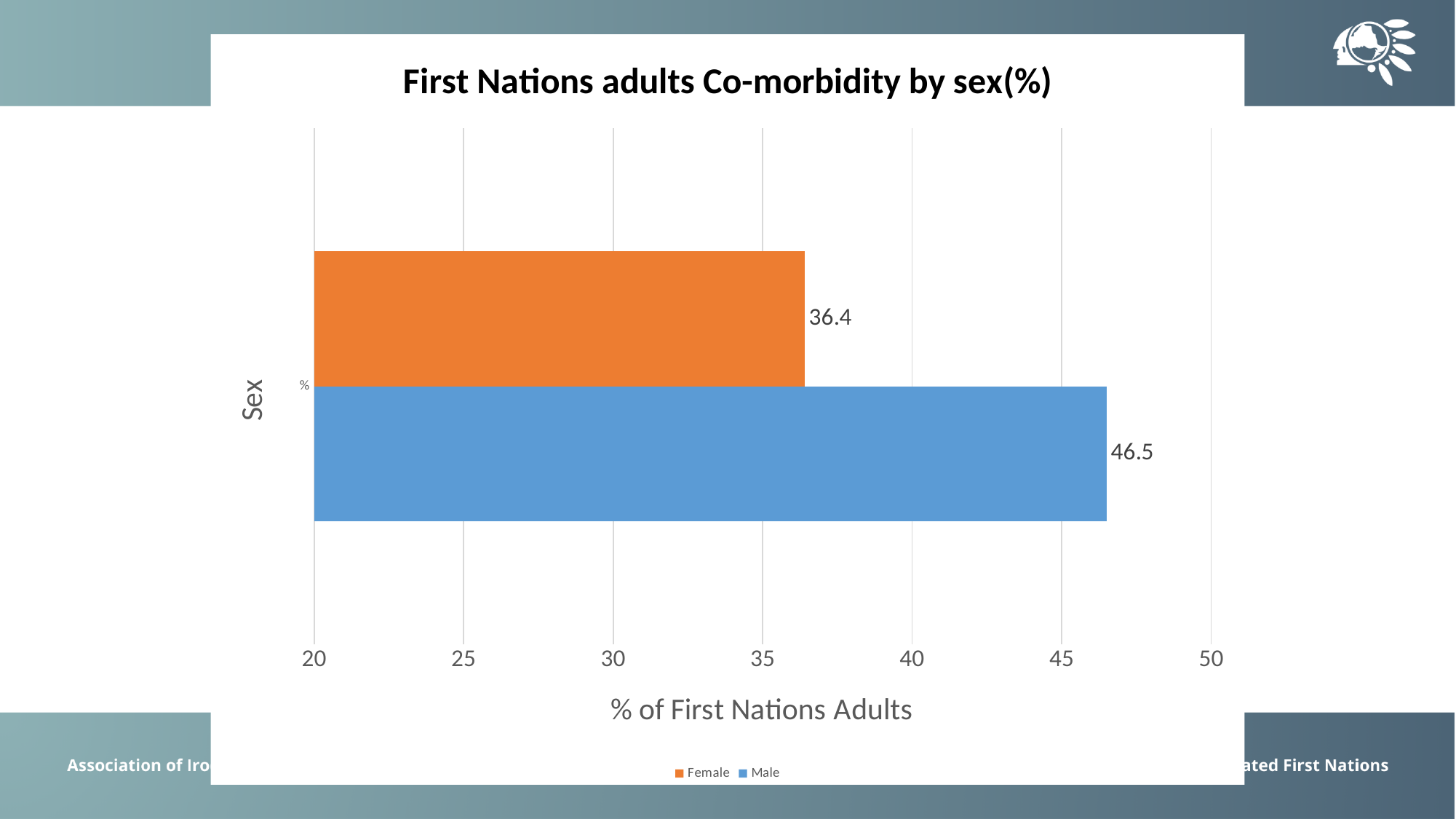
What is the label of the horizontal axis? % of First Nations Adults Is the value for Female greater or less than 40? less How many series does the legend list? 2 What is the value for Female in the chart? 36.4 Which series has the higher value, Female or Male? Male What is the value for Male in the chart? 46.5 Which series has the lowest value? Female What is the title of the chart? First Nations adults Co-morbidity by sex(%) What is the difference between the Male and Female values? 10.1 What kind of chart is shown on the slide? Bar chart Is the value for Male greater or less than 45? greater Which series has the highest value? Male